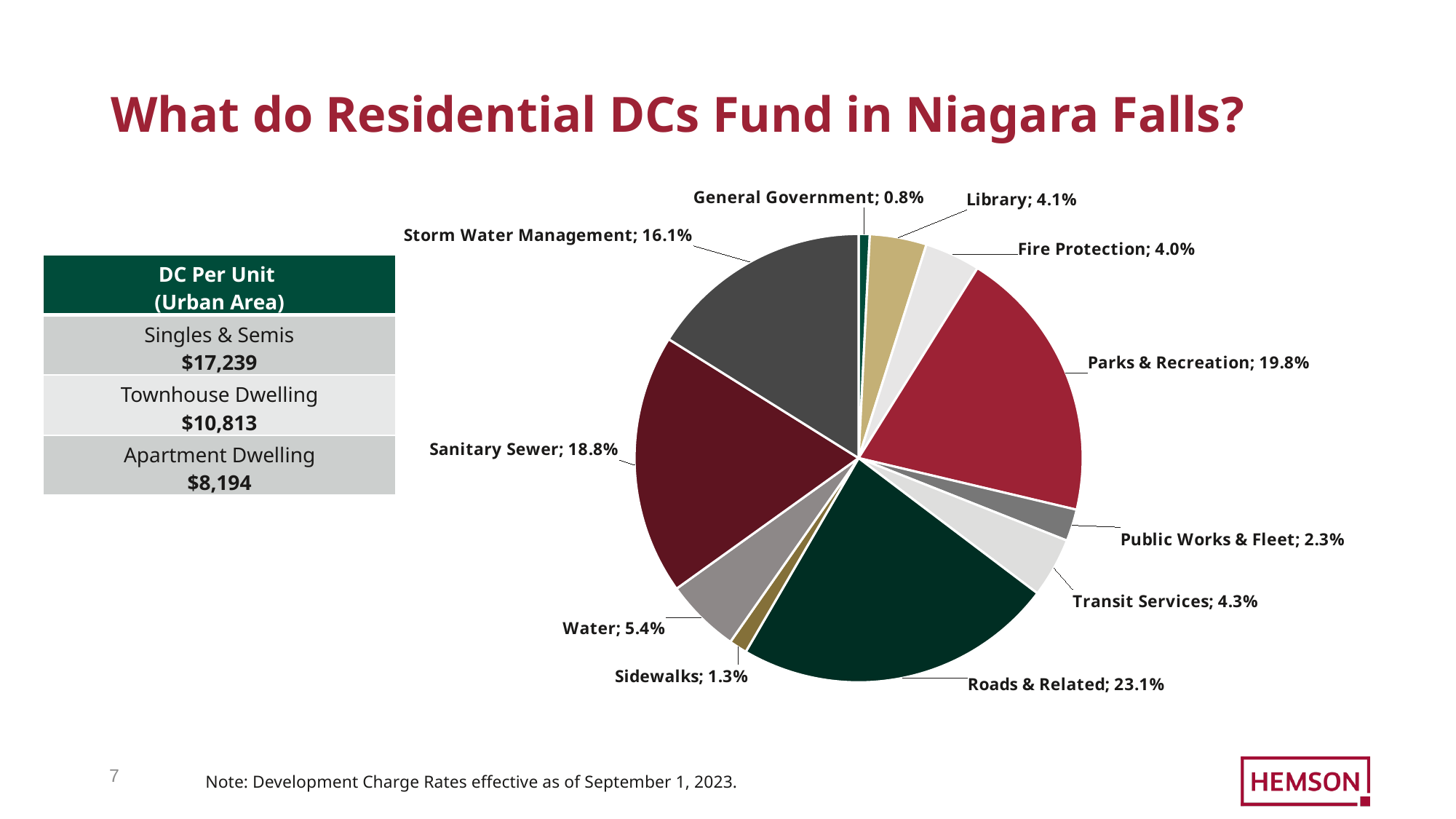
Which is larger, Library or Fire Protection? Library What kind of chart is shown on the slide? Pie chart What is the value shown for Sanitary Sewer? 18.8% What share of the pie does Roads & Related account for? 23.1% What is the difference in percentage points between Roads & Related and Parks & Recreation? 3.3 What is the title of the slide containing the pie chart? What do Residential DCs Fund in Niagara Falls? What is the value shown for Storm Water Management? 16.1% How many categories are shown in the pie chart? 11 Which category has the largest slice of the pie? Roads & Related Which category has the smallest slice of the pie? General Government What is the combined share of Water and Sidewalks? 6.7% What is the value shown for Public Works & Fleet? 2.3%